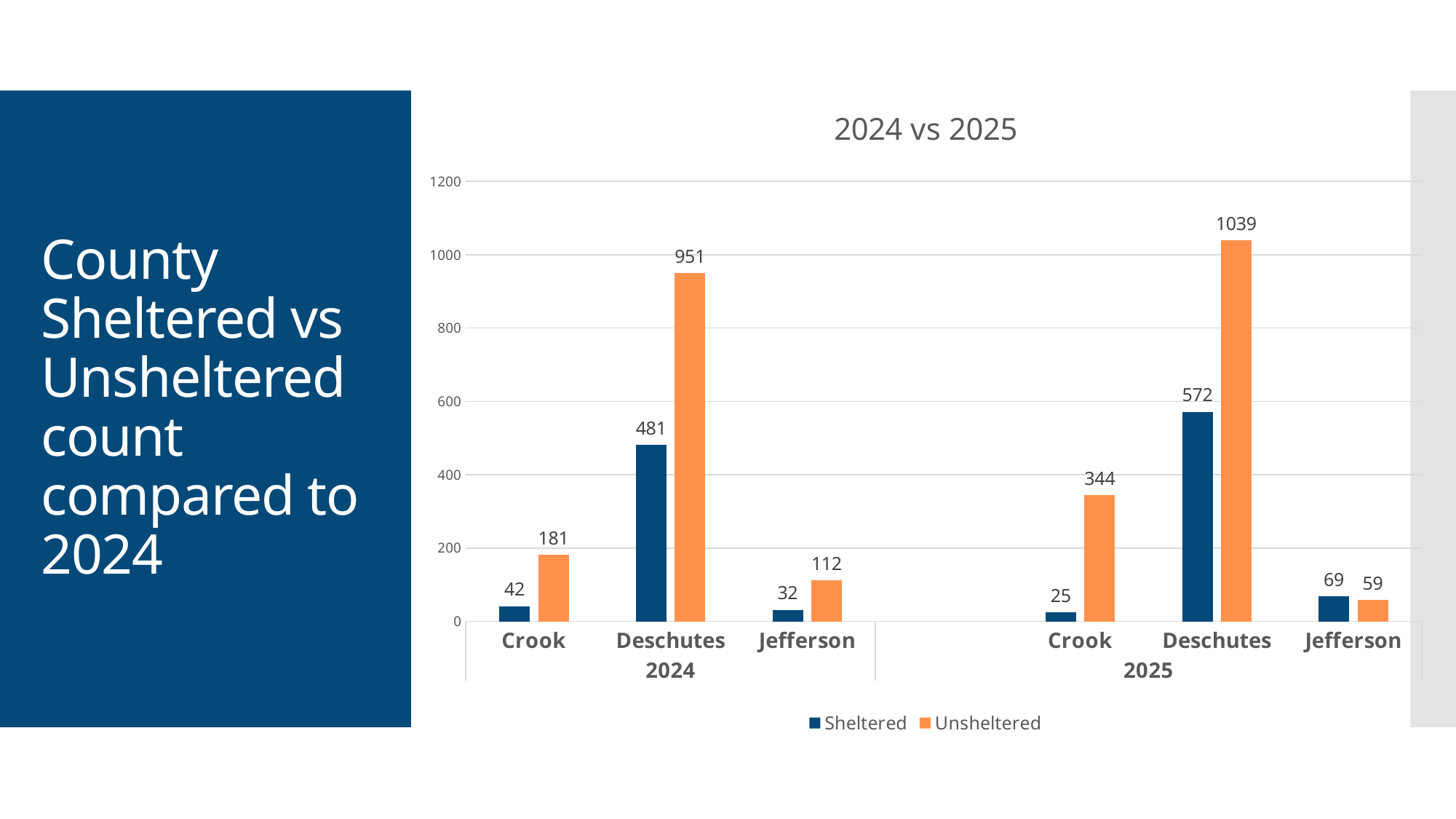
Which is larger for Jefferson in 2025, Sheltered or Unsheltered? Sheltered What is the Sheltered value for Crook in 2024? 42 Which county and year has the highest Unsheltered value? Deschutes 2025 What is the title of the chart? 2024 vs 2025 Is the Sheltered value for Deschutes in 2025 greater or less than 400? greater What is the difference between the Unsheltered values for Deschutes in 2025 and 2024? 88 Which county and year has the lowest Sheltered value? Crook 2025 What is the Unsheltered value for Jefferson in 2024? 112 What is the difference between the Sheltered and Unsheltered values for Crook in 2025? 319 What is the Unsheltered value for Deschutes in 2025? 1039 How many series does the legend list? 2 What kind of chart is shown on the slide? Bar chart